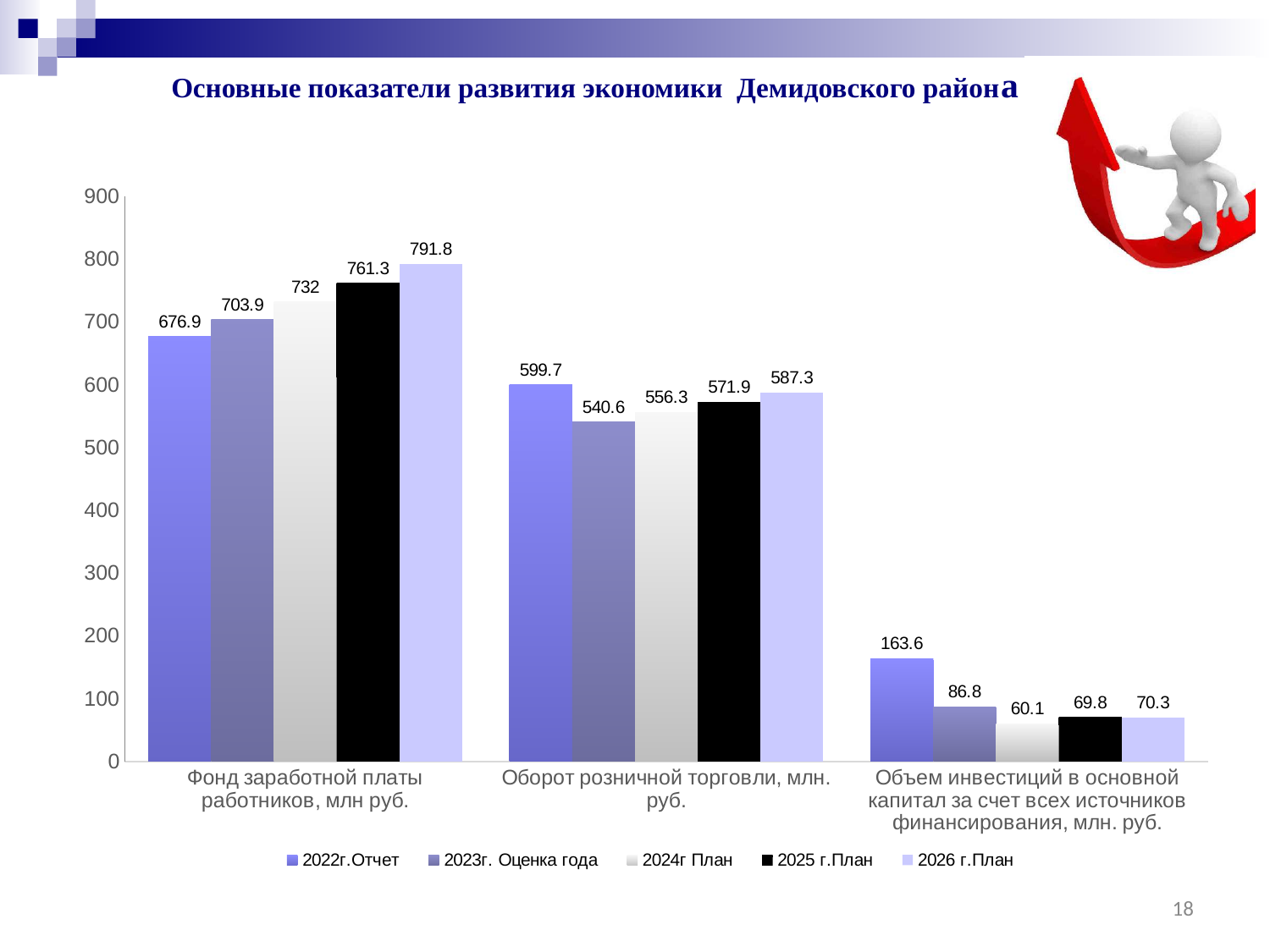
Which series has the lowest value in the category "Оборот розничной торговли, млн. руб."? 2023г. Оценка года How many categories are shown on the x axis of the chart? 3 What kind of chart is shown on the slide? Bar chart Which is larger in the category "Оборот розничной торговли, млн. руб.": the 2022г.Отчет value or the 2025 г.План value? 2022г.Отчет What is the value for 2022г.Отчет in the category "Фонд заработной платы работников, млн руб."? 676.9 What is the difference between the 2026 г.План and 2022г.Отчет values in the category "Фонд заработной платы работников, млн руб."? 114.9 What is the difference between the 2022г.Отчет and 2023г. Оценка года values in the category "Объем инвестиций в основной капитал за счет всех источников финансирования, млн. руб."? 76.8 How many series does the legend list? 5 Do the values for "Фонд заработной платы работников, млн руб." rise or fall from 2022г.Отчет to 2026 г.План? Rise What is the value for 2024г План in the category "Объем инвестиций в основной капитал за счет всех источников финансирования, млн. руб."? 60.1 What is the value for 2026 г.План in the category "Оборот розничной торговли, млн. руб."? 587.3 Which series has the highest value in the category "Фонд заработной платы работников, млн руб."? 2026 г.План